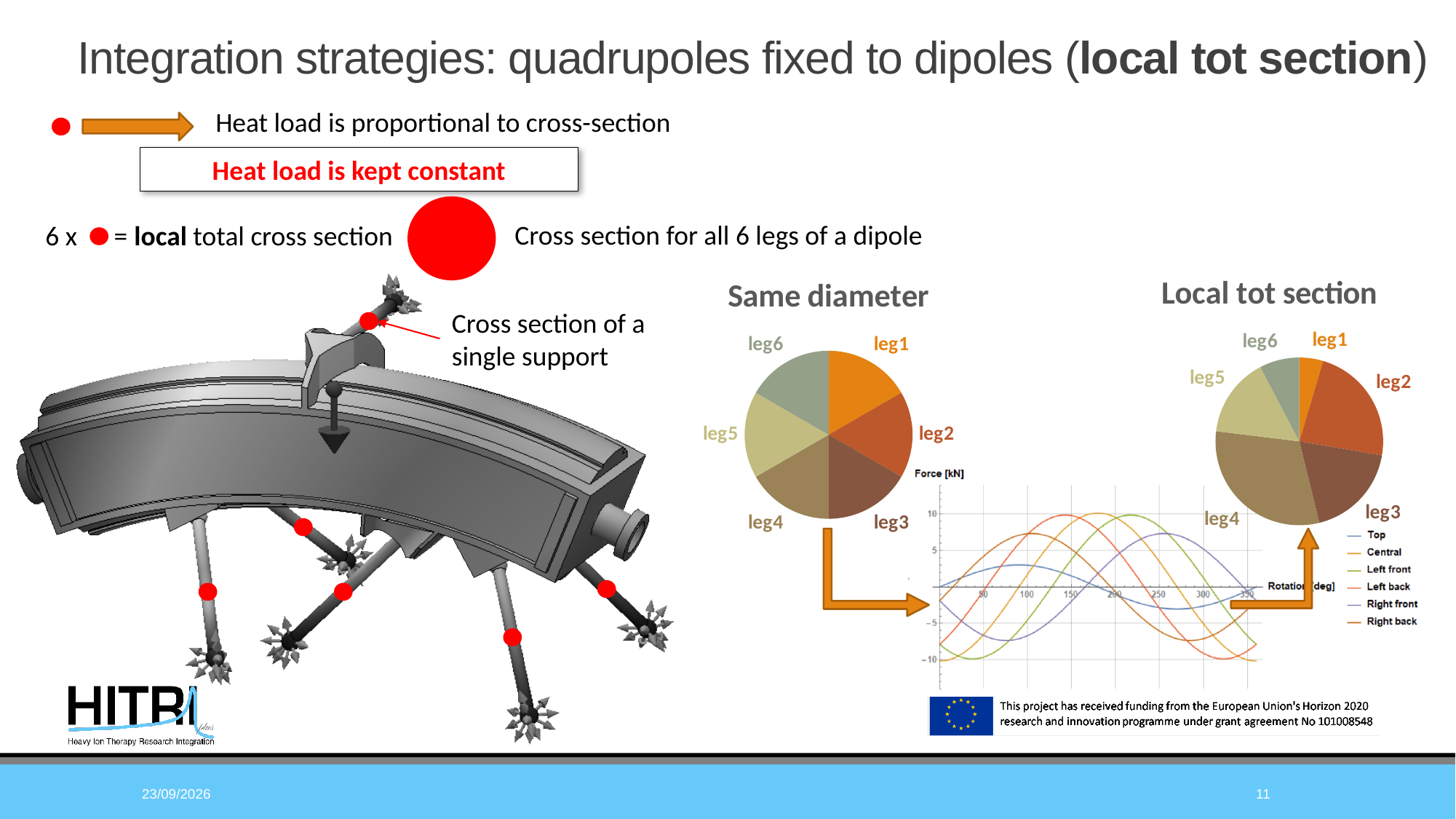
What are the titles of the two pie charts on the slide? Same diameter and Local tot section How many slices does the "Same diameter" pie chart have? 6 In the "Local tot section" pie chart, which leg has the smallest slice? leg1 In the "Local tot section" pie chart, which slice is larger, leg5 or leg6? leg5 In the "Local tot section" pie chart, which slice is larger, leg4 or leg1? leg4 What is the x-axis label of the Force [kN] line chart? Rotation [deg] In the "Local tot section" pie chart, which slice is larger, leg1 or leg2? leg2 How many slices does the "Local tot section" pie chart have? 6 What kind of chart is the Force [kN] versus Rotation [deg] chart in the lower right? line chart How many series does the legend of the Force [kN] line chart list? 6 What kind of chart is the "Local tot section" chart? pie chart What kind of chart is the "Same diameter" chart? pie chart